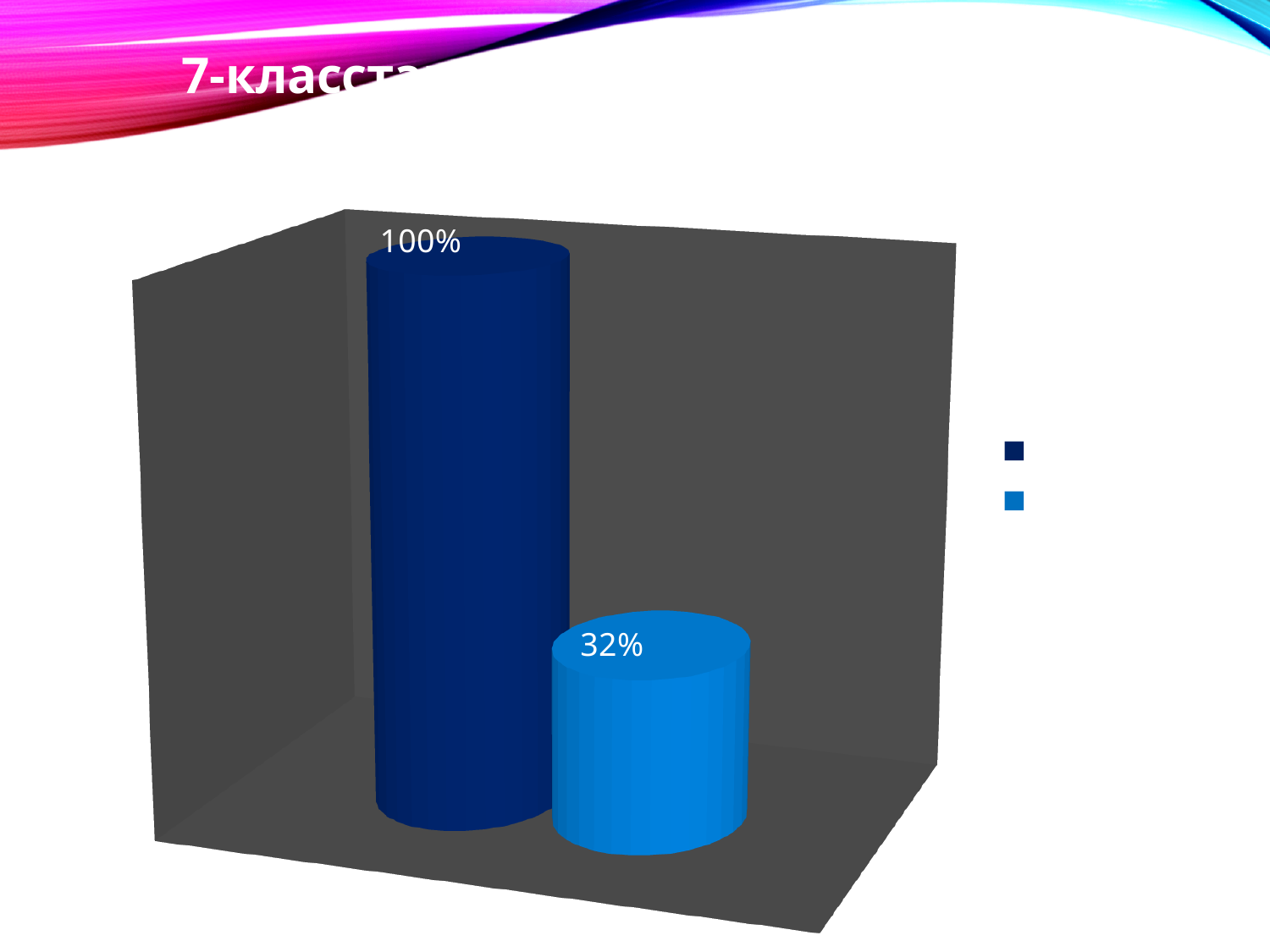
What value is printed on the dark blue bar? 100% Which bar has the highest value, the dark blue one or the light blue one? the dark blue bar How many entries does the legend show? 2 What value is printed on the light blue bar? 32% Is the value of the light blue bar larger or smaller than the value of the dark blue bar? smaller Do the values fall or rise from the left bar to the right bar? fall What is the difference between the dark blue bar's value and the light blue bar's value? 68 percentage points What kind of chart is shown on the slide? bar chart What colour is the bar labelled 100%? dark blue What colour is the bar labelled 32%? light blue How many bars are plotted on the chart? 2 Which bar has the lowest value, the dark blue one or the light blue one? the light blue bar